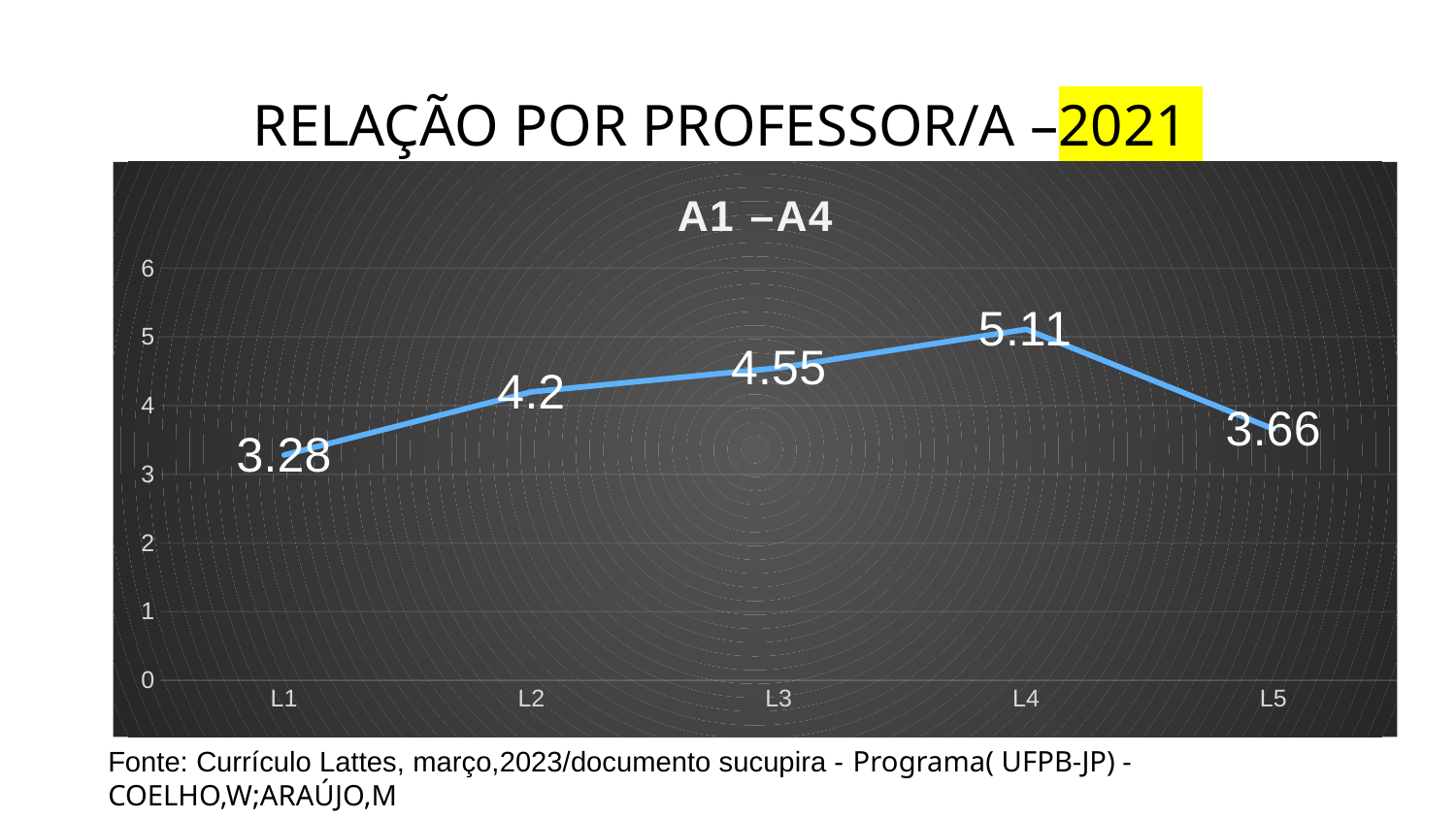
What is the difference between the values for L4 and L1? 1.83 What kind of chart is shown? line chart How many categories are plotted on the x axis? 5 What is the title of the chart? A1 –A4 What is the value for L3? 4.55 Which category has the lowest value? L1 Is the value for L4 greater or less than 5? greater Do the values rise or fall from L1 to L4? rise Which category has the highest value? L4 What is the value for L5? 3.66 What is the value for L1? 3.28 Which is larger, the value for L2 or the value for L5? L2